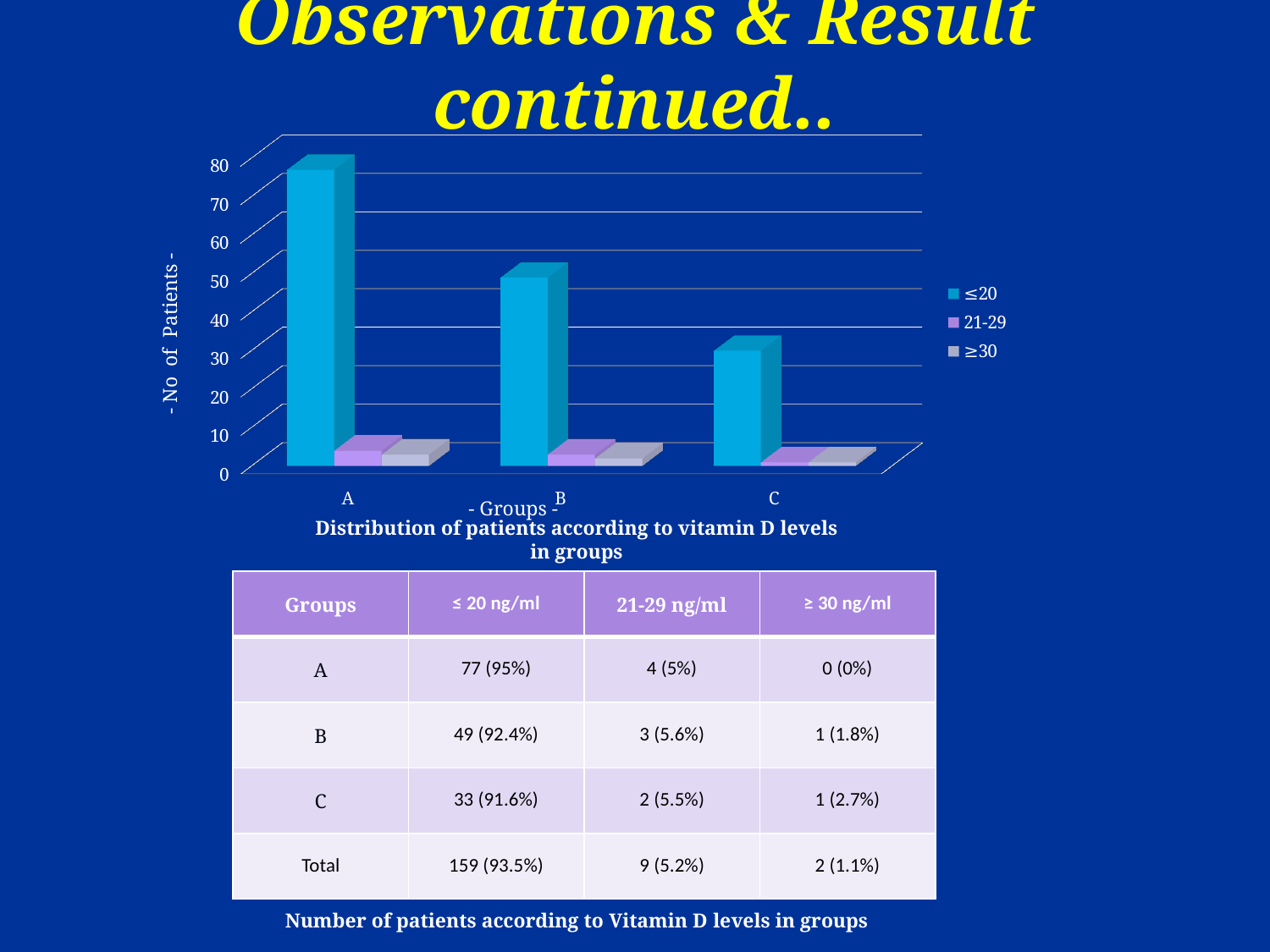
How many groups are shown on the x axis of the chart? 3 Which group has the lowest value for the ≤20 series? C Is the ≤20 value for group A greater or less than 70? greater Is the ≤20 value for group B greater or less than 40? greater Do the ≤20 values rise or fall from group A to group C? fall How many series does the chart legend list? 3 What is the title printed below the chart? Distribution of patients according to vitamin D levels in groups What kind of chart is shown on the slide? bar chart Which is larger, the ≤20 value for group B or for group C? group B Which group has the highest value for the ≤20 series? A Is the ≤20 value for group C greater or less than 40? less What is the label of the y axis of the chart? - No of Patients -